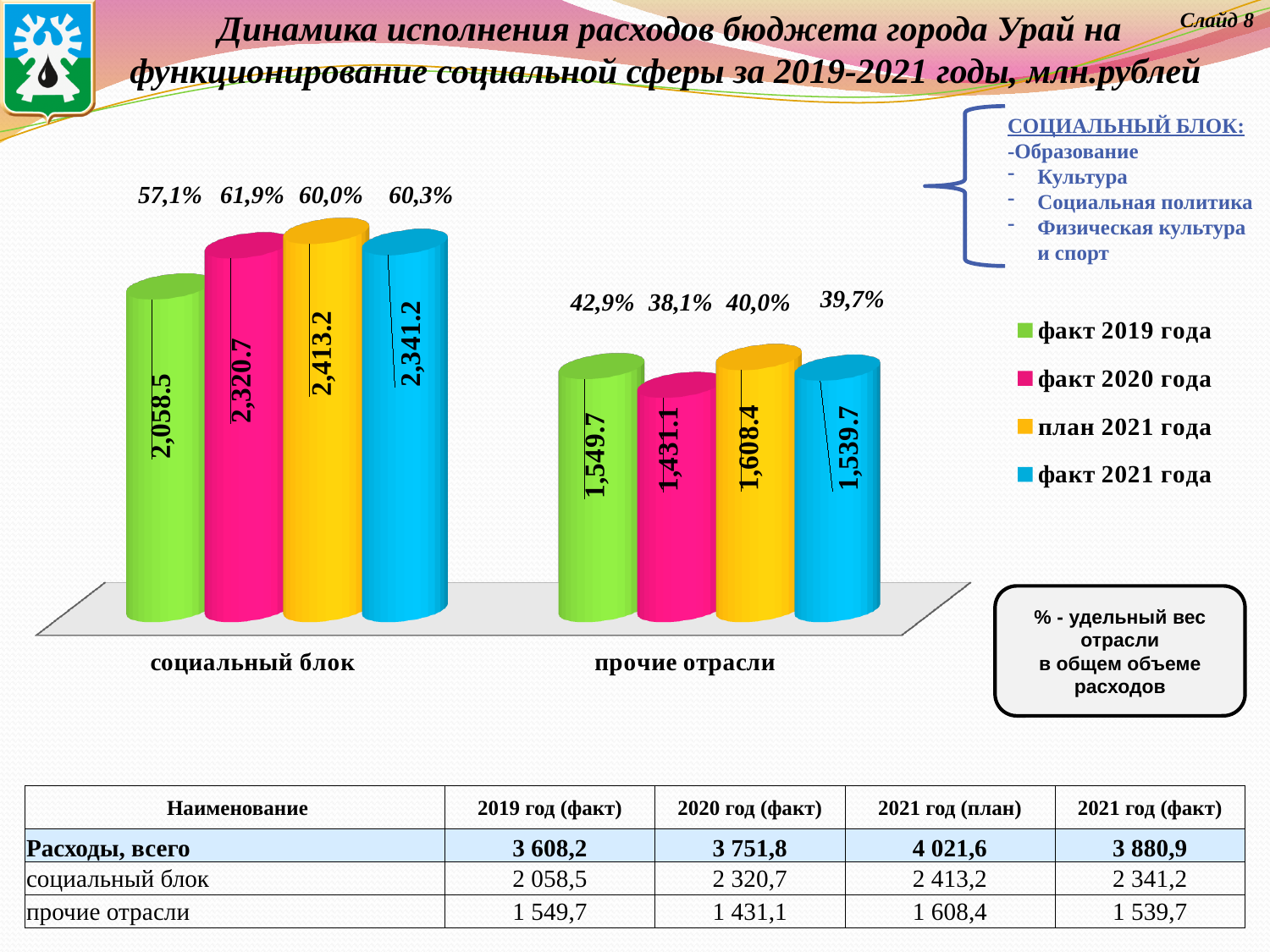
What is the value for прочие отрасли in the план 2021 года series? 1,608.4 Which is larger in the факт 2020 года series: социальный блок or прочие отрасли? социальный блок Which series has the lowest value for прочие отрасли? факт 2020 года What kind of chart is shown on the slide? bar chart For прочие отрасли, does the value rise or fall from факт 2019 года to факт 2020 года? fall How many categories are shown on the x axis of the chart? 2 What is the difference between план 2021 года and факт 2021 года for социальный блок? 72.0 How many series does the legend list? 4 What is the value for социальный блок in the факт 2019 года series? 2,058.5 What percentage share is printed above the факт 2020 года bar for социальный блок? 61,9% What is the difference between факт 2019 года and факт 2021 года for прочие отрасли? 10.0 Which series has the highest value for социальный блок? план 2021 года